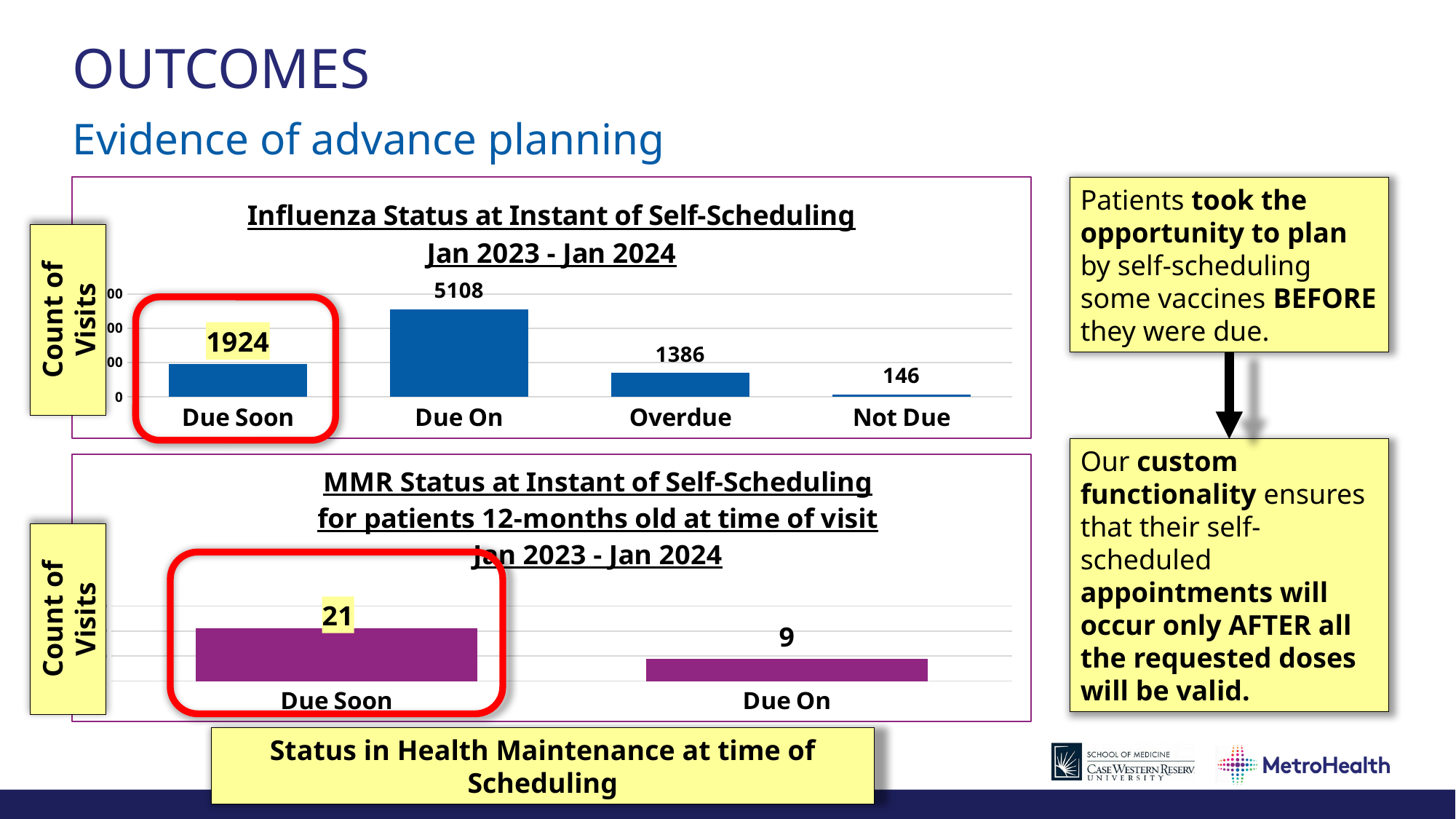
How many categories are shown in the MMR Status chart? 2 In the Influenza Status chart, what is the count of visits for Overdue? 1386 What type of chart is the MMR Status chart? Bar chart In the MMR Status chart, what is the count of visits for Due On? 9 How many categories are shown in the Influenza Status chart? 4 In the Influenza Status chart, which category has the highest count of visits? Due On In the Influenza Status chart, what is the count of visits for Due Soon? 1924 In the MMR Status chart, what is the count of visits for Due Soon? 21 In the Influenza Status chart, what is the difference between the Due On and Due Soon counts? 3184 In the MMR Status chart, what is the difference between the Due Soon and Due On counts? 12 In the Influenza Status chart, which is larger, Overdue or Not Due? Overdue In the Influenza Status chart, which category has the lowest count of visits? Not Due